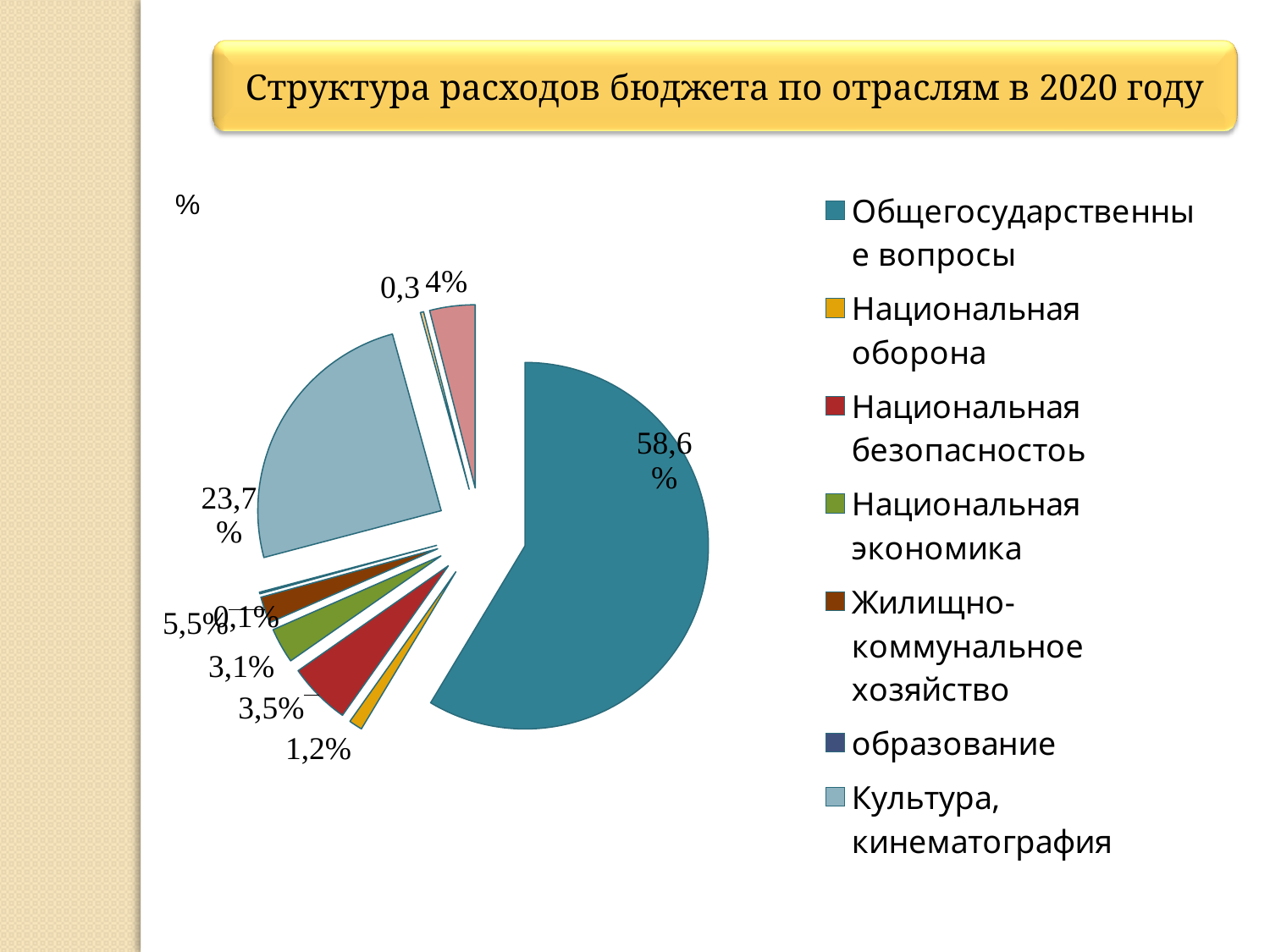
What share of budget expenditure is shown for Общегосударственные вопросы? 58,6% What is the title of the chart on the slide? Структура расходов бюджета по отраслям в 2020 году How many entries does the legend list? 7 What kind of chart is shown on the slide? pie chart What share is shown for Жилищно-коммунальное хозяйство? 5,5% What share is shown for Национальная оборона? 1,2% What share is shown for Культура, кинематография? 23,7% What is the difference between the shares for Общегосударственные вопросы and Культура, кинематография? 34,9% Which is larger, the share for Национальная безопасность or for Национальная экономика? Национальная безопасность Which category has the largest slice of the pie? Общегосударственные вопросы What share is shown for Национальная безопасность? 3,5% What share is shown for Национальная экономика? 3,1%